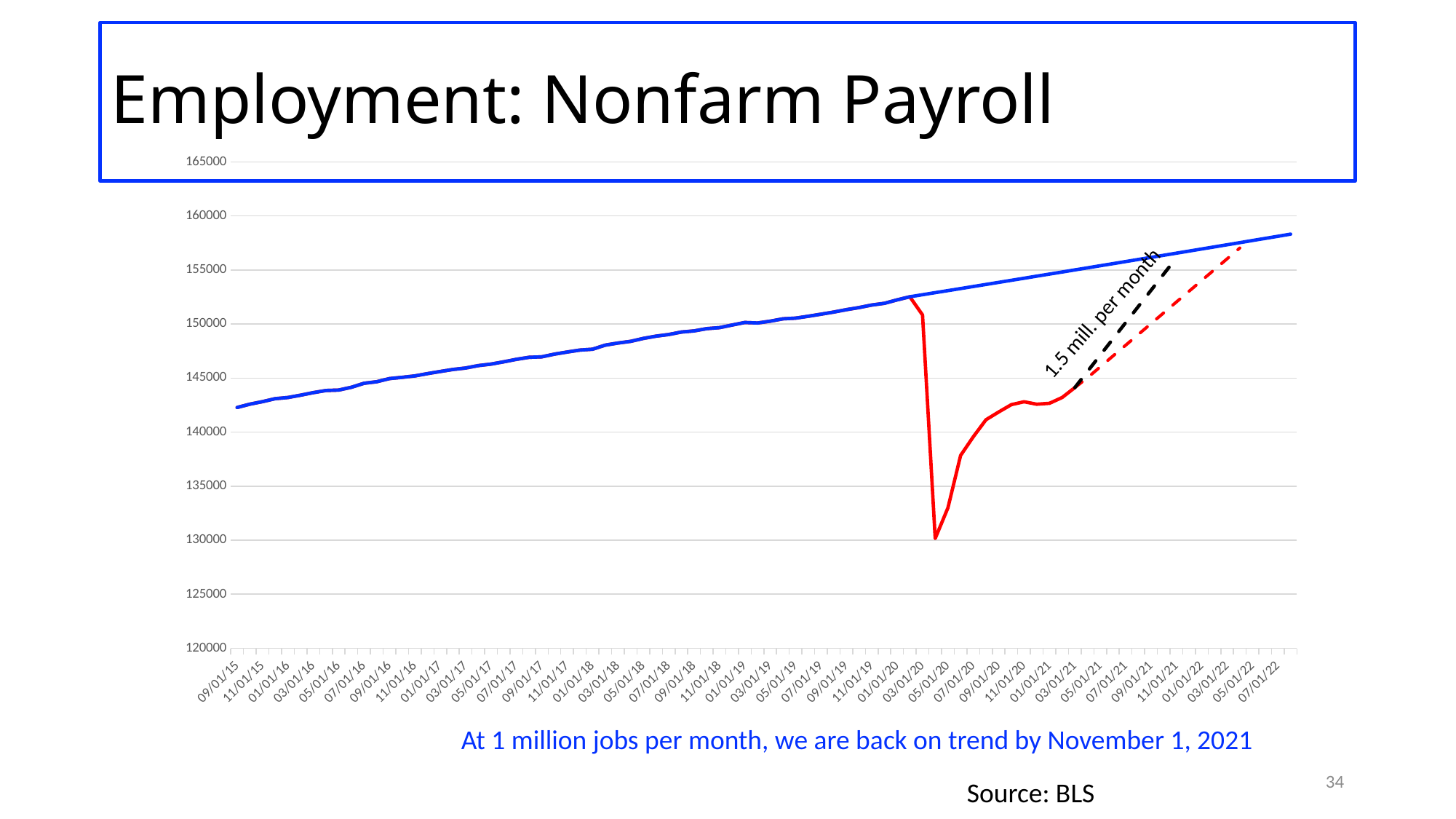
Is the value of the blue line at 09/01/15 greater or less than 145000? less What is the title of the slide containing the chart? Employment: Nonfarm Payroll Is the value of the red line at 01/01/21 greater or less than 145000? less Is the lowest point of the red line greater or less than 135000? less Does the blue trend line rise or fall from left to right across the chart? rise Which is higher: the blue line at 01/01/20 or the blue line at 09/01/15? 01/01/20 Which is higher: the blue line at 07/01/22 or the red line at 01/01/21? the blue line at 07/01/22 What kind of chart is shown on the slide? line chart What rate is written next to the black dashed line on the chart? 1.5 mill. per month